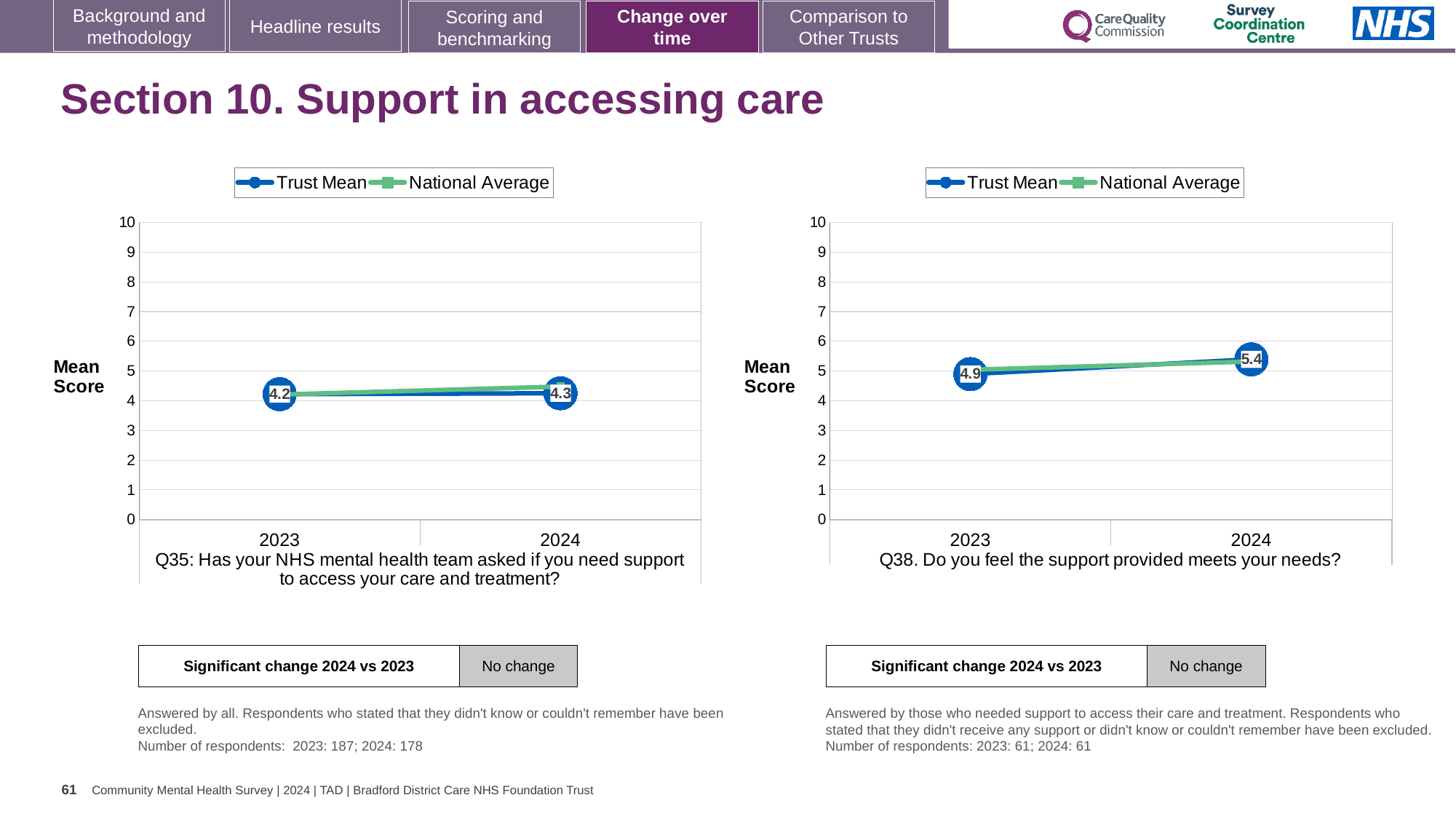
In the Q35 chart on the left, what is the difference between the Trust Mean for 2024 and 2023? 0.1 How many series does the legend of the Q38 chart on the right list? 2 What kind of chart is the Q35 chart on the left? line chart In the Q38 chart on the right, by how much did the Trust Mean change from 2023 to 2024? 0.5 Which series is shown in green in the legend of the Q35 chart on the left? National Average How many years are plotted on the x axis of the Q35 chart on the left? 2 In the Q38 chart on the right, what is the Trust Mean score for 2024? 5.4 In the Q38 chart on the right, is the Trust Mean for 2024 greater or less than 5? greater In the Q35 chart on the left, what is the Trust Mean score for 2023? 4.2 In the Q35 chart on the left, what is the Trust Mean score for 2024? 4.3 In the Q38 chart on the right, does the Trust Mean rise or fall from 2023 to 2024? rise In the Q38 chart on the right, what is the Trust Mean score for 2023? 4.9